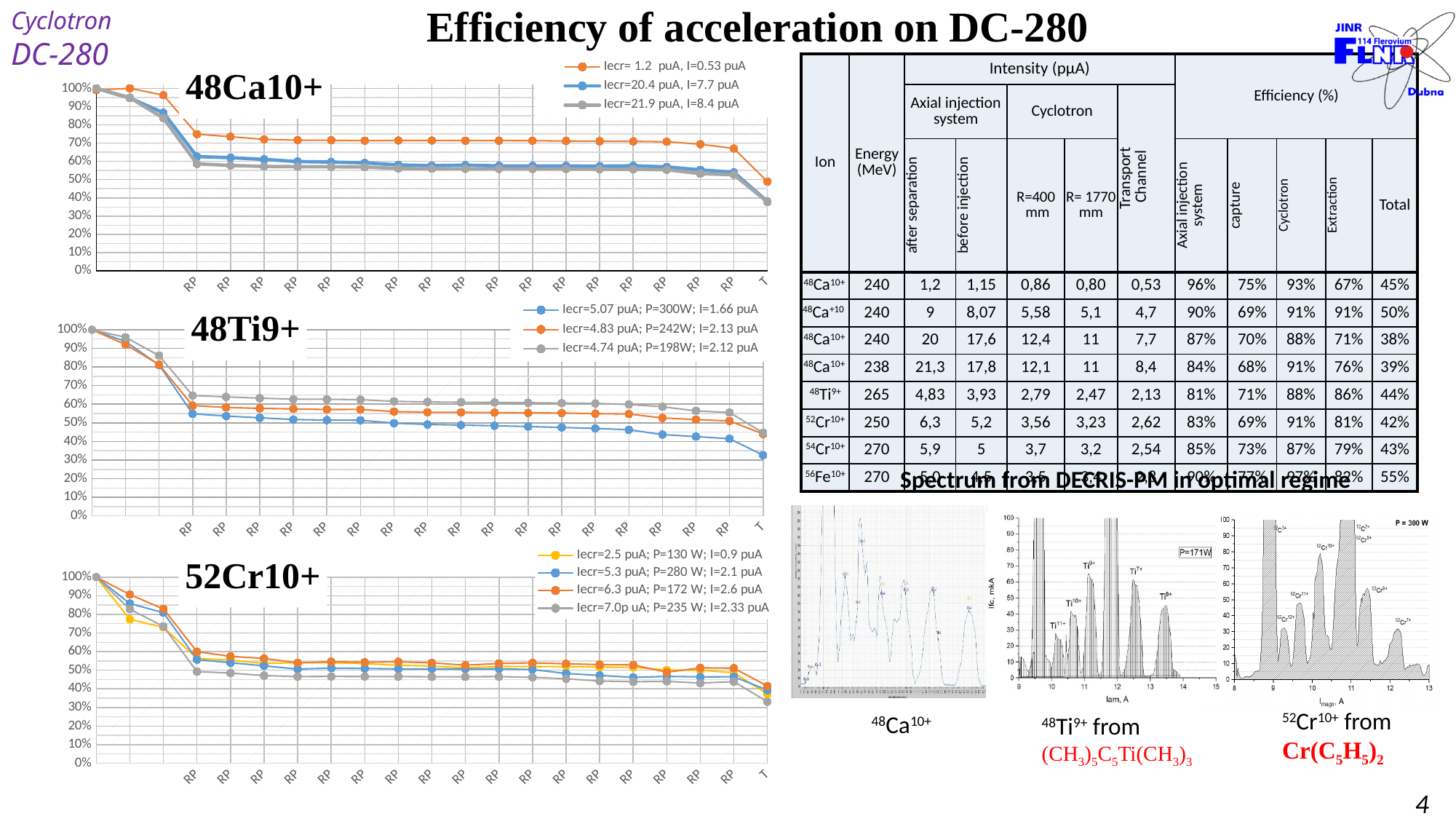
What kind of chart is the 48Ca10+ chart on the left of the slide? line chart How many series does the legend of the 48Ca10+ chart list? 3 In the 48Ti9+ chart, is the value of the Iecr=5.07 puA; P=300W; I=1.66 puA series at the final point T greater or less than 40%? less In the 48Ca10+ chart, is the value of the Iecr=20.4 puA, I=7.7 puA series at the final point T greater or less than 50%? less In the 52Cr10+ chart, which series has the lowest values across the RP points? Iecr=7.0p uA; P=235 W; I=2.33 puA In the 48Ca10+ chart, is the value of the Iecr= 1.2 puA, I=0.53 puA series at the final point T greater or less than 40%? greater In the 48Ca10+ chart, do the values generally rise or fall from left to right along the x axis? fall What is the title of the middle chart on the left side of the slide? 48Ti9+ In the 48Ti9+ chart, which series has the lowest value at the final point T? Iecr=5.07 puA; P=300W; I=1.66 puA In the 48Ca10+ chart, which series has the highest values across the RP points? Iecr= 1.2 puA, I=0.53 puA How many series does the legend of the 52Cr10+ chart list? 4 In the 48Ti9+ chart, what is the value of the series at the first point on the x axis? 100%